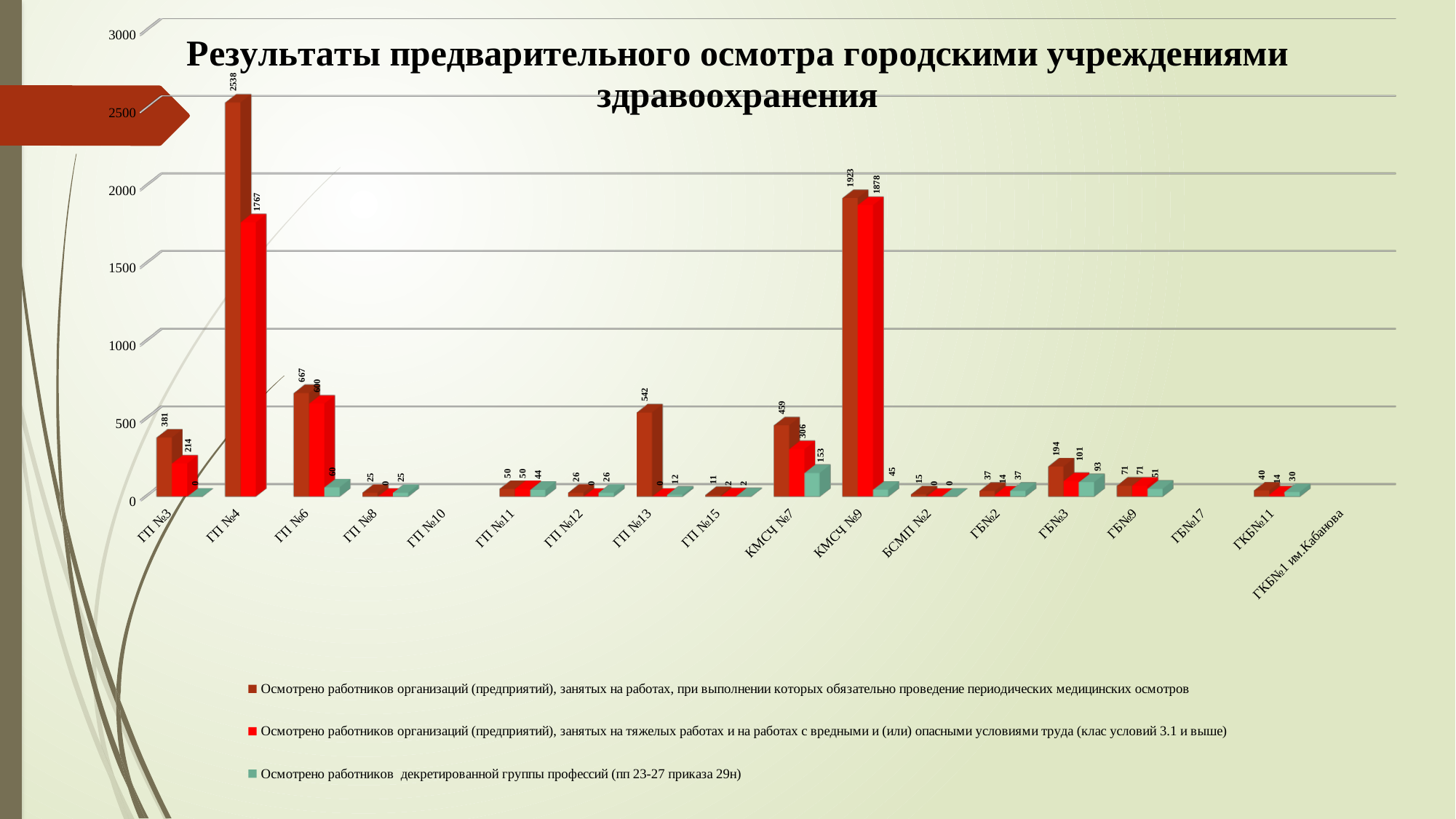
What is the difference between the dark red and red series values for ГП №4? 771 What is the teal series value (декретированной группы профессий) for ГБ№3? 93 Which institution has the highest value in the teal series (декретированной группы профессий)? КМСЧ №7 How many institutions (categories) are listed along the x axis? 18 What is the title of the chart? Результаты предварительного осмотра городскими учреждениями здравоохранения How many series does the legend list? 3 Which has the larger teal series value (декретированной группы профессий): КМСЧ №7 or ГБ№3? КМСЧ №7 What type of chart is shown on the slide? bar chart What is the dark red series value (периодических медицинских осмотров) for КМСЧ №9? 1923 What is the red series value (тяжелых работах, клас условий 3.1 и выше) for ГБ№9? 71 Which institution has the highest value in the dark red series (периодических медицинских осмотров)? ГП №4 What is the red series value (тяжелых работах, клас условий 3.1 и выше) for КМСЧ №7? 306